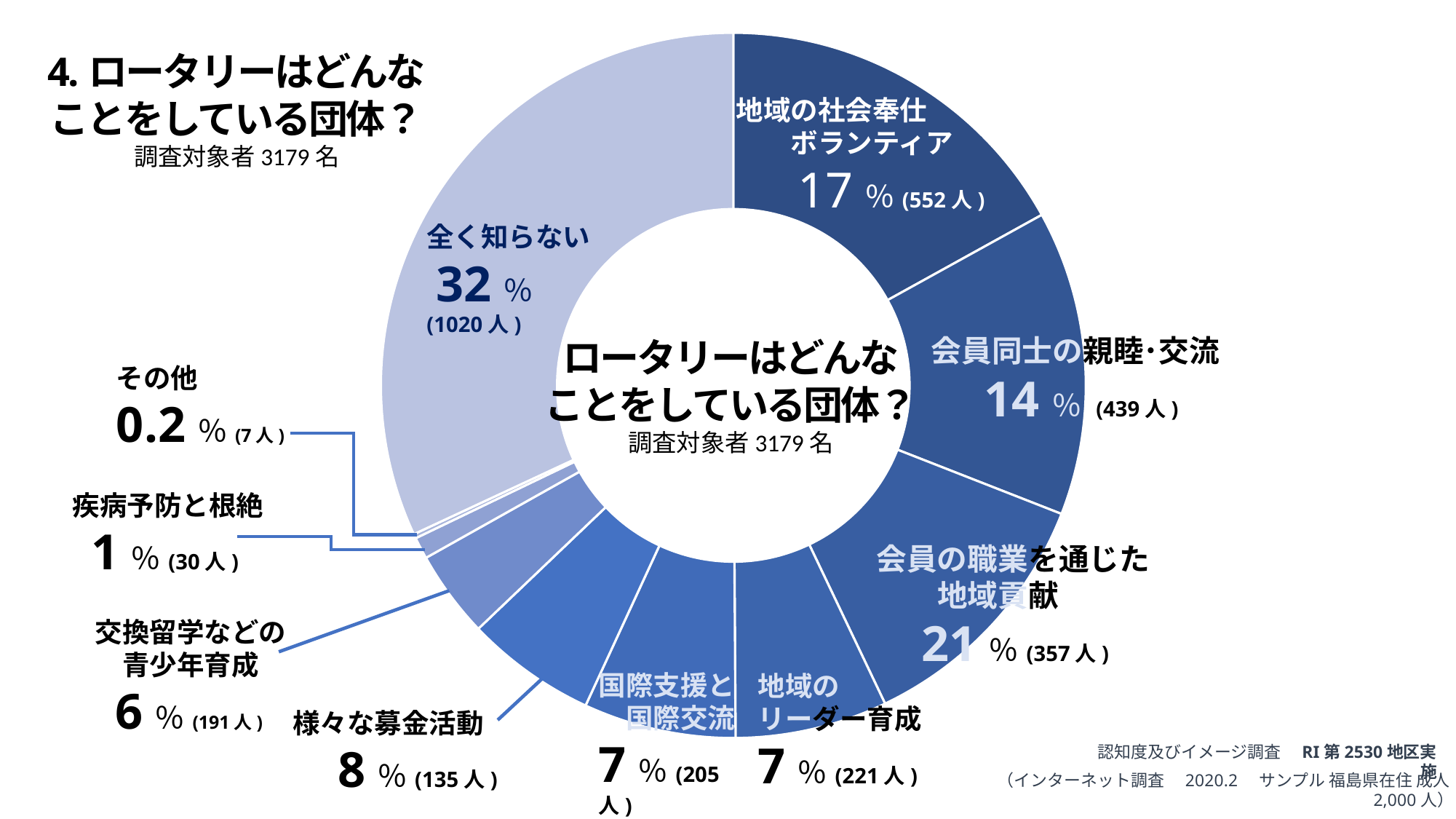
What percentage is shown for 疾病予防と根絶? 1% How many people (人) are shown for 様々な募金活動? 135人 What is the difference in percentage points between 全く知らない and 地域の社会奉仕ボランティア? 15 percentage points How many people (人) are shown for 地域の社会奉仕ボランティア? 552人 What percentage is shown for 全く知らない? 32% Which category has the smallest share of the chart? その他 What percentage is shown for 会員同士の親睦・交流? 14% What type of chart is shown on the slide? Donut (pie) chart Which has more respondents, 交換留学などの青少年育成 or 様々な募金活動? 交換留学などの青少年育成 How many categories are shown in the chart? 10 Which category has the largest share of the chart? 全く知らない How many survey respondents (調査対象者) are stated in the chart's center? 3179名